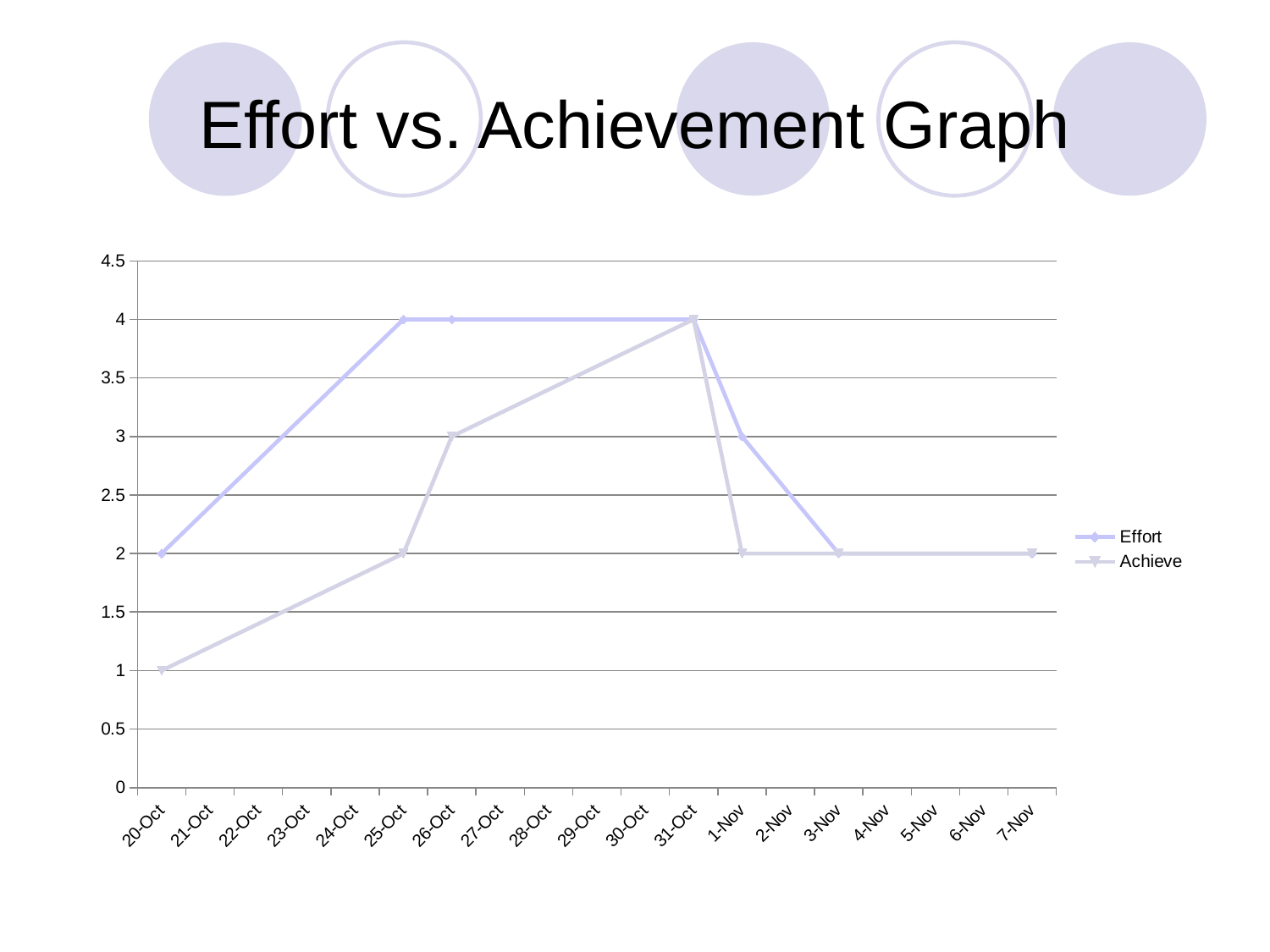
On 20-Oct, which series has the larger value, Effort or Achieve? Effort What is the Achieve value on 20-Oct? 1 What kind of chart is shown on the slide? line chart What is the Effort value on 1-Nov? 3 How many series does the legend list? 2 What is the difference between the Effort and Achieve values on 25-Oct? 2 On which date does the Achieve series reach its highest value? 31-Oct What are the two entries in the legend? Effort, Achieve What is the Effort value on 20-Oct? 2 What is the Achieve value on 26-Oct? 3 How many dates are shown on the x axis? 19 Does the Effort line rise or fall from 31-Oct to 3-Nov? fall